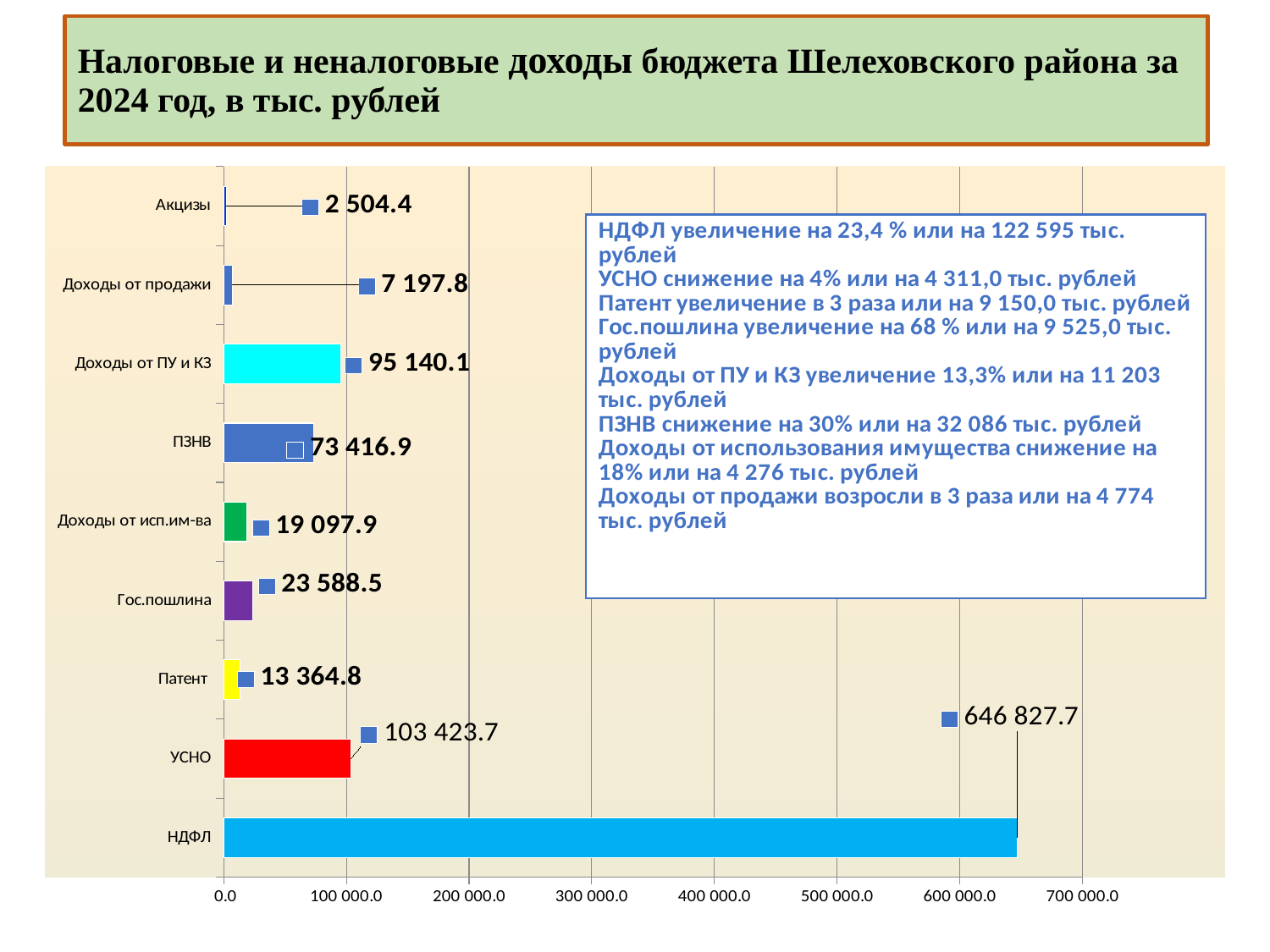
What is the value for Патент? 13 364.8 What is the title of the slide? Налоговые и неналоговые доходы бюджета Шелеховского района за 2024 год, в тыс. рублей What is the value for НДФЛ? 646 827.7 What is the difference between the values for УСНО and Доходы от ПУ и КЗ? 8 283.6 Which category has the highest value? НДФЛ How many categories are shown in the chart? 9 What is the value for УСНО? 103 423.7 What is the value for Гос.пошлина? 23 588.5 What is the value for Акцизы? 2 504.4 What kind of chart is shown on the slide? Bar chart Which category has the lowest value? Акцизы Which is larger, the value for ПЗНВ or the value for Доходы от исп.им-ва? ПЗНВ